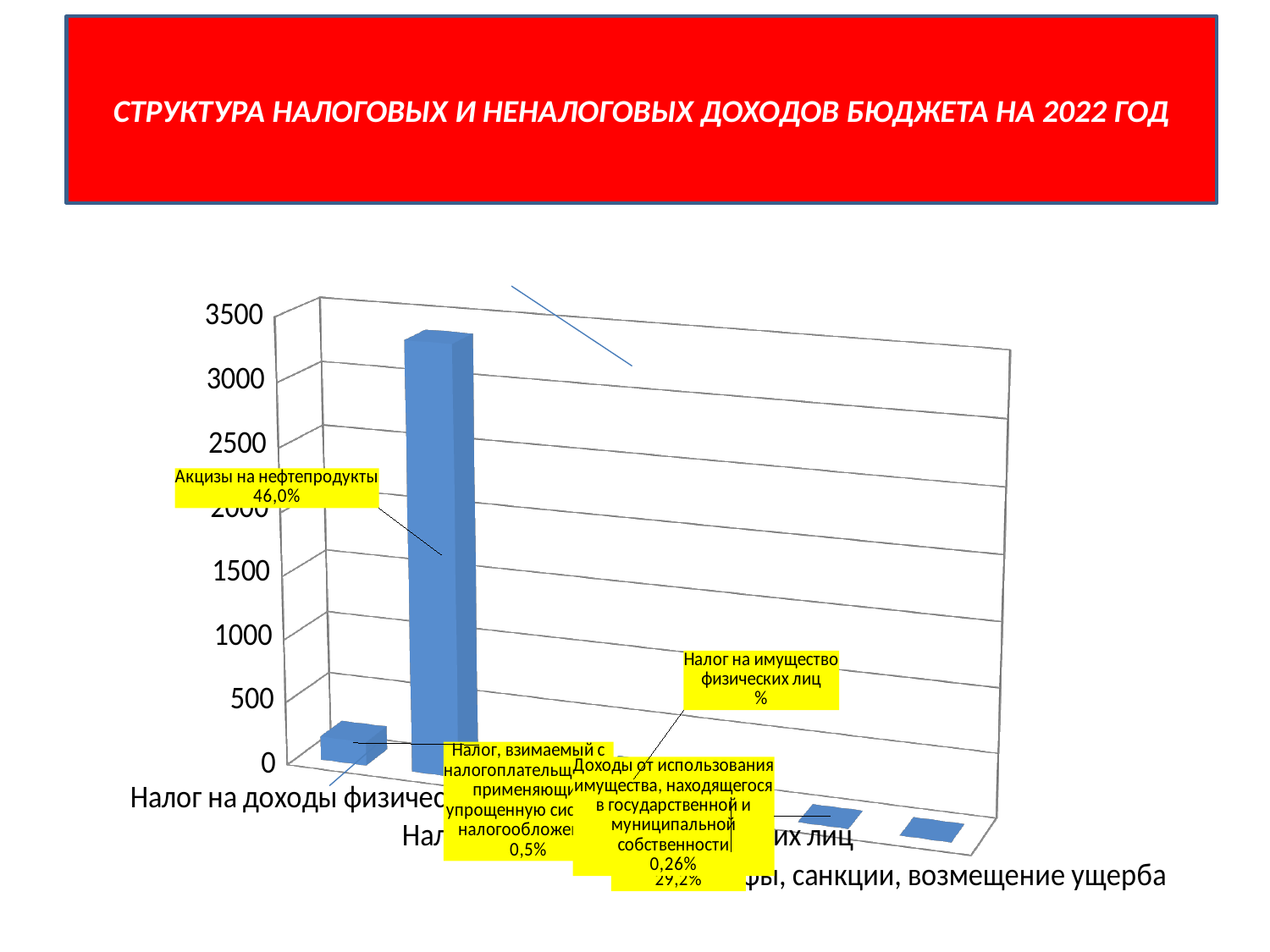
Is the value of the tallest bar (Акцизы на нефтепродукты) greater or less than 3000? greater What share is shown in the callout for Доходы от использования имущества, находящегося в государственной и муниципальной собственности? 0,26% What share is shown in the callout for Налог, взимаемый с налогоплательщиков, применяющих упрощенную систему налогообложения? 0,5% What is the highest value shown on the vertical axis? 3500 What share is shown in the callout for Акцизы на нефтепродукты? 46,0% What kind of chart is shown on the slide? bar chart Is the value of the first bar on the left (Налог на доходы физических лиц) greater or less than 500? less Which category has the tallest bar in the chart? Акцизы на нефтепродукты Which bar is larger: the first bar on the left or the second bar (Акцизы на нефтепродукты)? Акцизы на нефтепродукты What is the title of the slide containing the chart? СТРУКТУРА НАЛОГОВЫХ И НЕНАЛОГОВЫХ ДОХОДОВ БЮДЖЕТА НА 2022 ГОД